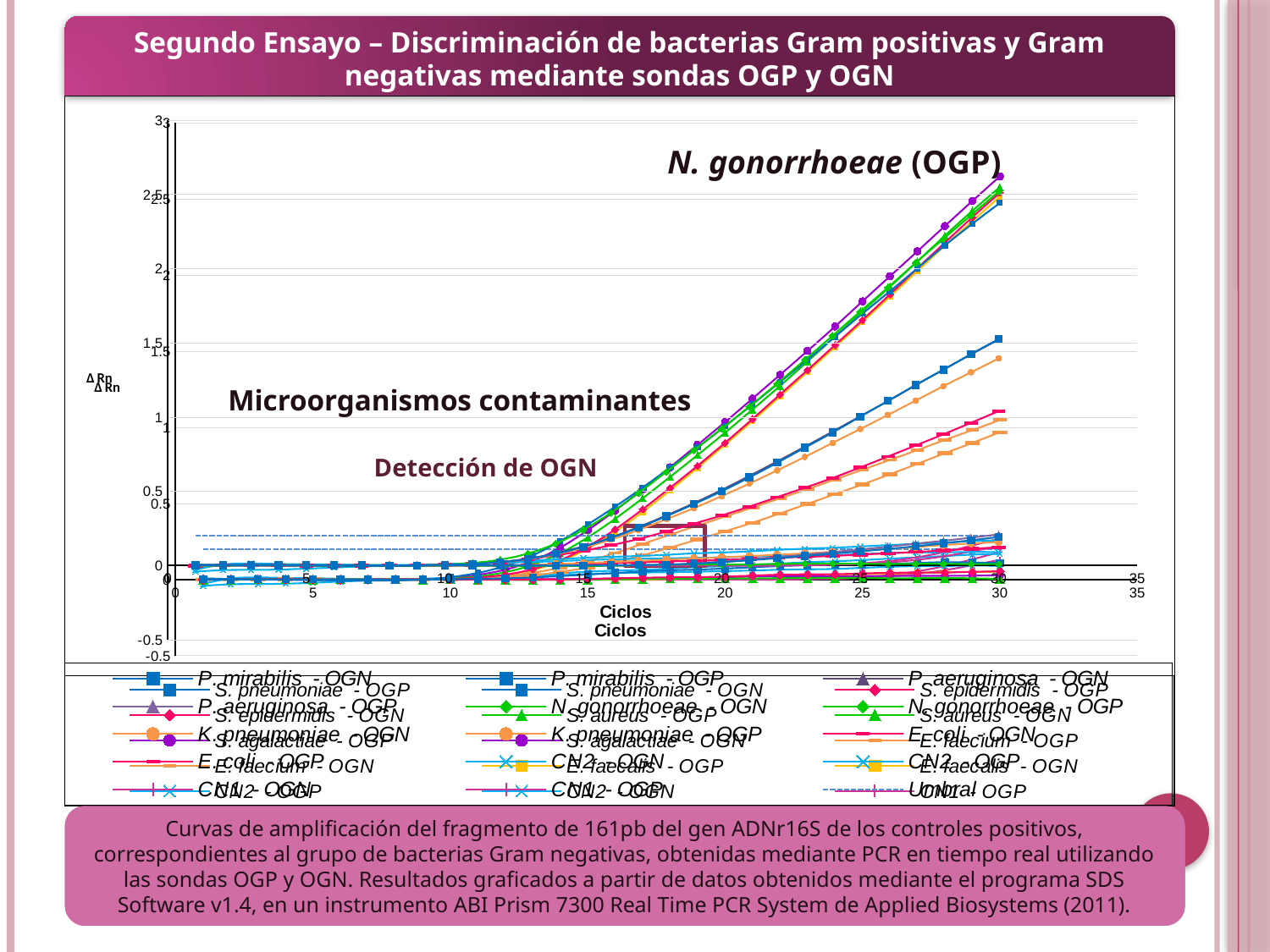
At cycle 5, are the curve values greater or less than 1? less What is the title of the x axis of the chart? Ciclos At cycle 30, is the value of the highest curve greater or less than 2? greater Do the top curves rise or fall as the number of cycles increases from 15 to 30? rise What kind of chart is shown on the slide? line chart At cycle 10, are the values of the curves greater or less than 0.5? less Which organism and probe does the annotation next to the highest group of curves name? N. gonorrhoeae (OGP)